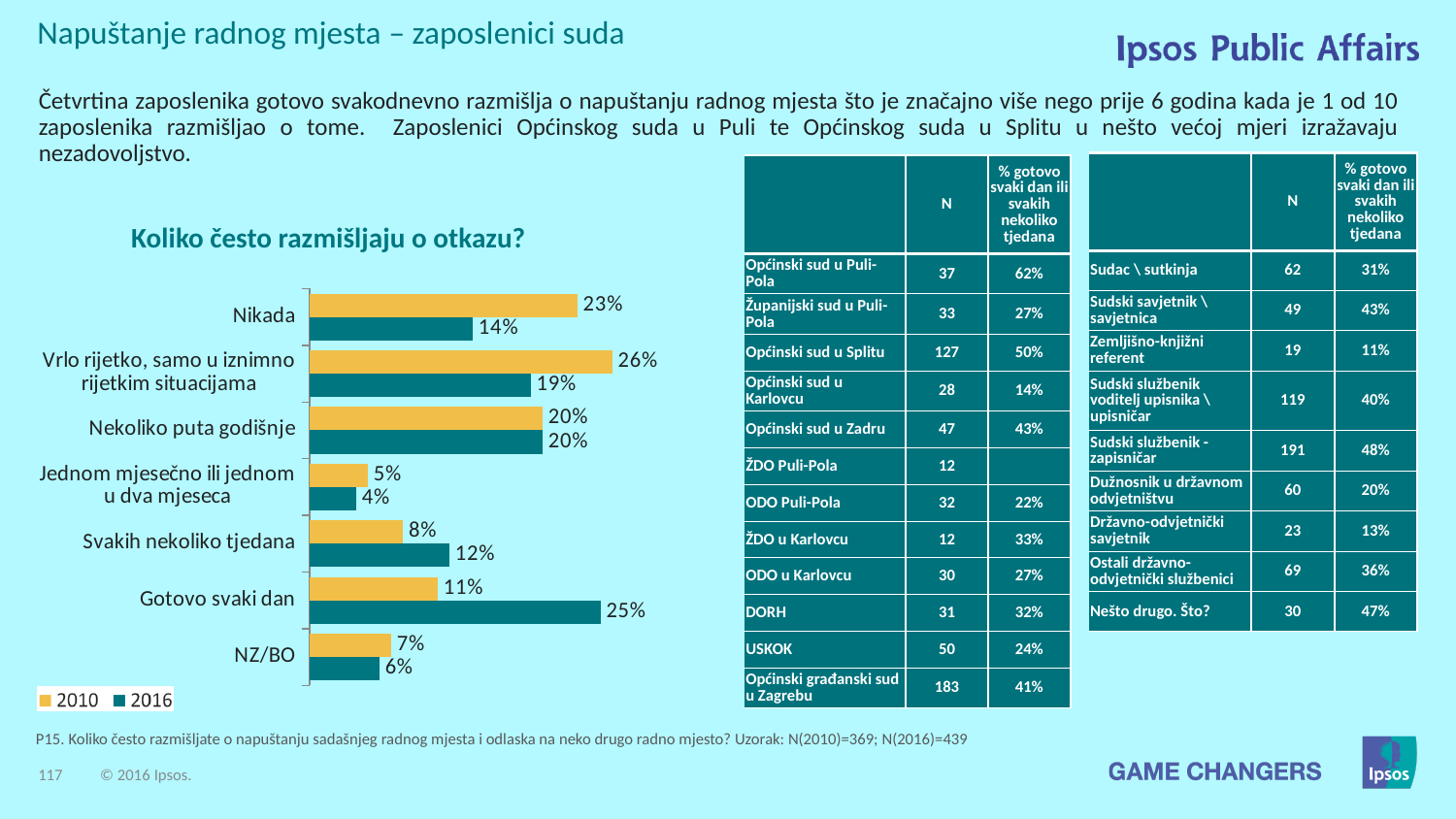
What is the difference between the 2010 and 2016 values for "Vrlo rijetko, samo u iznimno rijetkim situacijama"? 7% Which is larger for "Nikada": the 2010 value or the 2016 value? 2010 Which category has the lowest 2016 value? Jednom mjesečno ili jednom u dva mjeseca What is the 2016 value for "Gotovo svaki dan"? 25% What is the 2010 value for "Nikada"? 23% Which series is shown in yellow in the chart? 2010 What is the difference between the 2016 and 2010 values for "Gotovo svaki dan"? 14% Which category has the highest 2010 value? Vrlo rijetko, samo u iznimno rijetkim situacijama How many categories are shown on the chart? 7 What is the 2010 value for "Svakih nekoliko tjedana"? 8% What kind of chart is shown under the title "Koliko često razmišljaju o otkazu?"? bar chart How many series does the legend of the chart list? 2